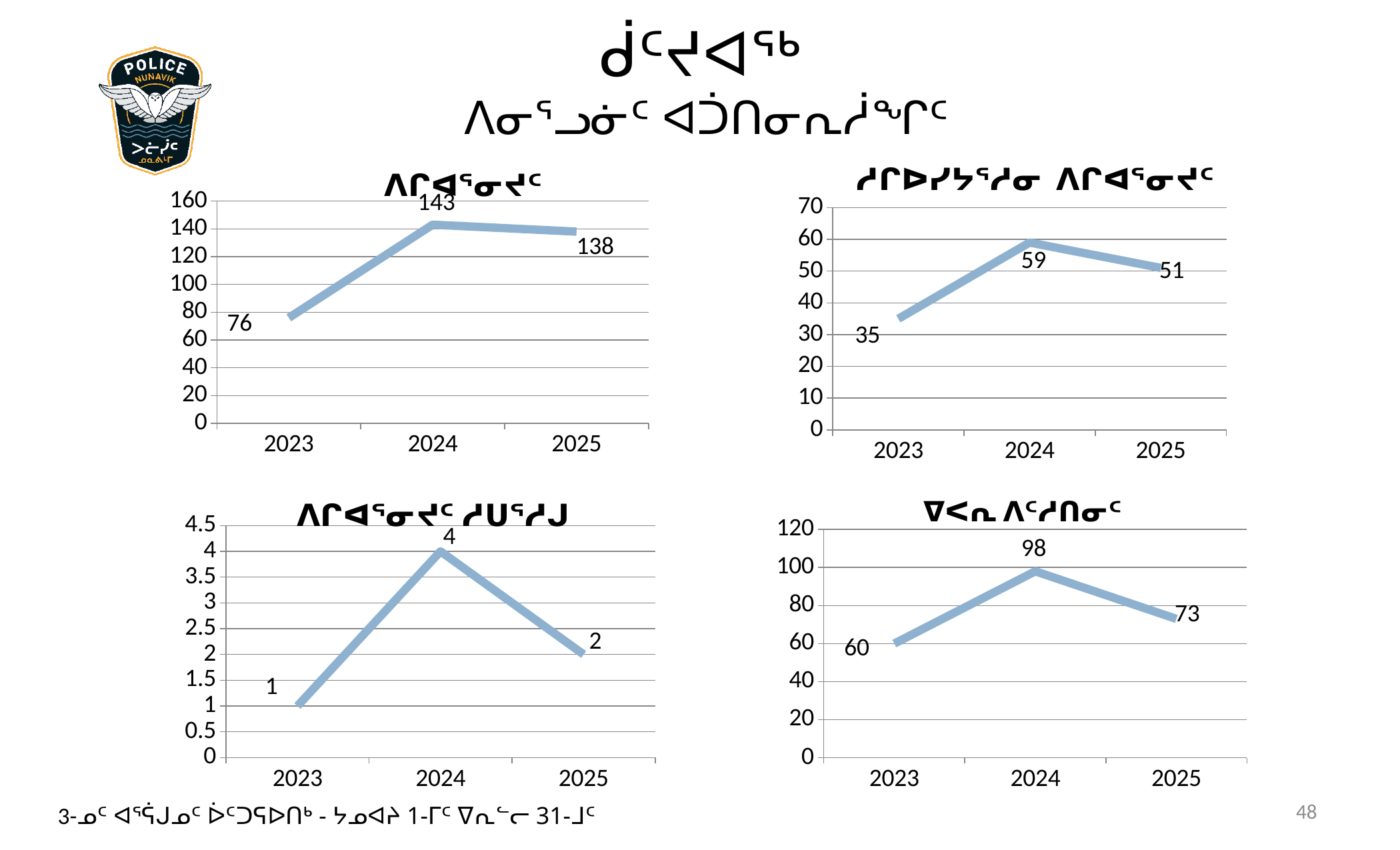
In the top-left chart, what is the value for 2024? 143 In the top-left chart, what is the value for 2023? 76 How many data points are plotted in the bottom-right chart? 3 In the top-left chart, what is the difference between the 2024 and 2025 values? 5 In the bottom-right chart, which is larger, the value for 2025 or the value for 2023? 2025 What kind of chart is the top-left chart? line chart In the bottom-right chart, what is the value for 2023? 60 In the top-right chart, what is the value for 2025? 51 In the top-right chart, what is the difference between the 2024 and 2023 values? 24 In the bottom-left chart, which year has the highest value? 2024 In the top-right chart, which year has the lowest value? 2023 In the bottom-left chart, what is the value for 2024? 4